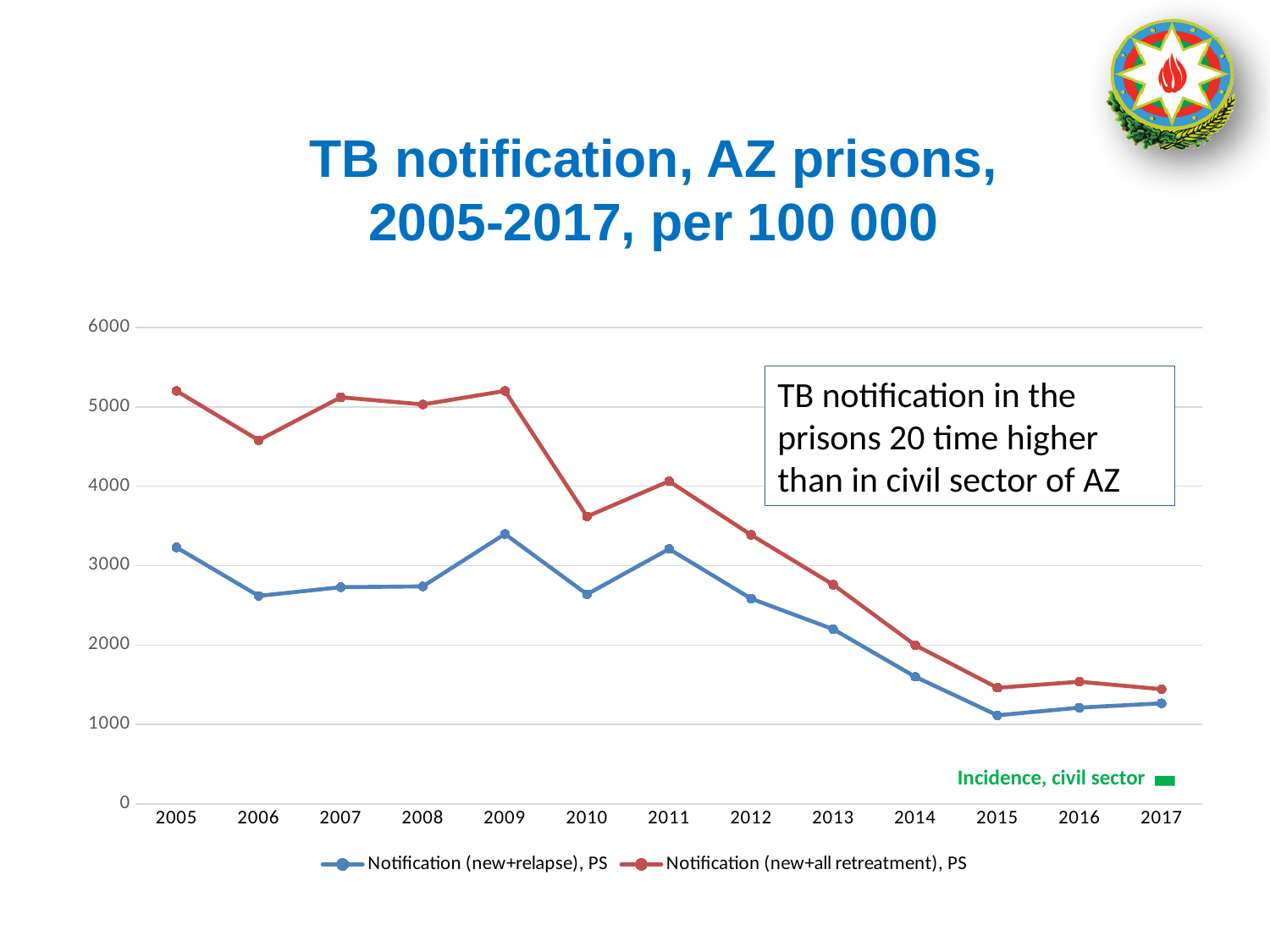
Is the value for Notification (new+all retreatment), PS in 2010 greater or less than 4000? less In which year is the value for Notification (new+relapse), PS lowest? 2015 Is the value for Notification (new+all retreatment), PS in 2006 greater or less than 5000? less How many series does the legend list? 2 In 2011, which series has the larger value: Notification (new+relapse), PS or Notification (new+all retreatment), PS? Notification (new+all retreatment), PS What is the title of the chart? TB notification, AZ prisons, 2005-2017, per 100 000 How many years are plotted along the x axis? 13 Which colour is used for the Notification (new+relapse), PS series? blue Is the value for Notification (new+relapse), PS in 2009 greater or less than 3000? greater In which year is the value for Notification (new+relapse), PS highest? 2009 What kind of chart is shown on the slide? line chart Overall, do the values for Notification (new+all retreatment), PS rise or fall from 2005 to 2017? fall